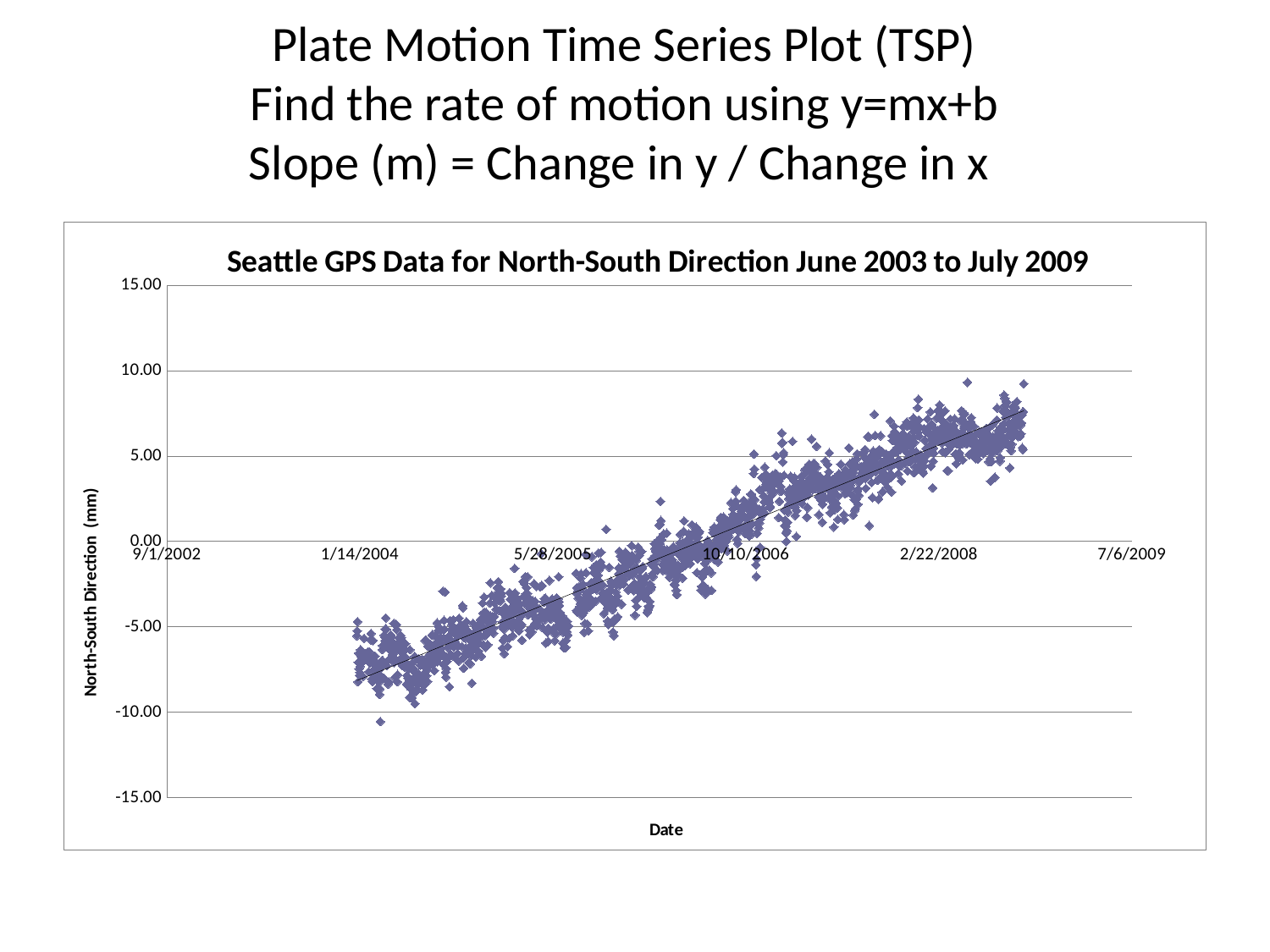
What is the label of the vertical axis? North-South Direction (mm) Are the plotted values near 2/22/2008 larger or smaller than those near 1/14/2004? larger Is the plotted value around 1/14/2004 greater or less than -5.00? less Is the plotted value around 2/22/2008 greater or less than 0.00? greater What is the highest value shown on the vertical axis? 15.00 Is the plotted value around 1/14/2004 greater or less than 0.00? less What is the title of the chart? Seattle GPS Data for North-South Direction June 2003 to July 2009 What kind of chart is shown on the slide? scatter chart Do the plotted North-South Direction values rise or fall as the date increases along the x axis? rise